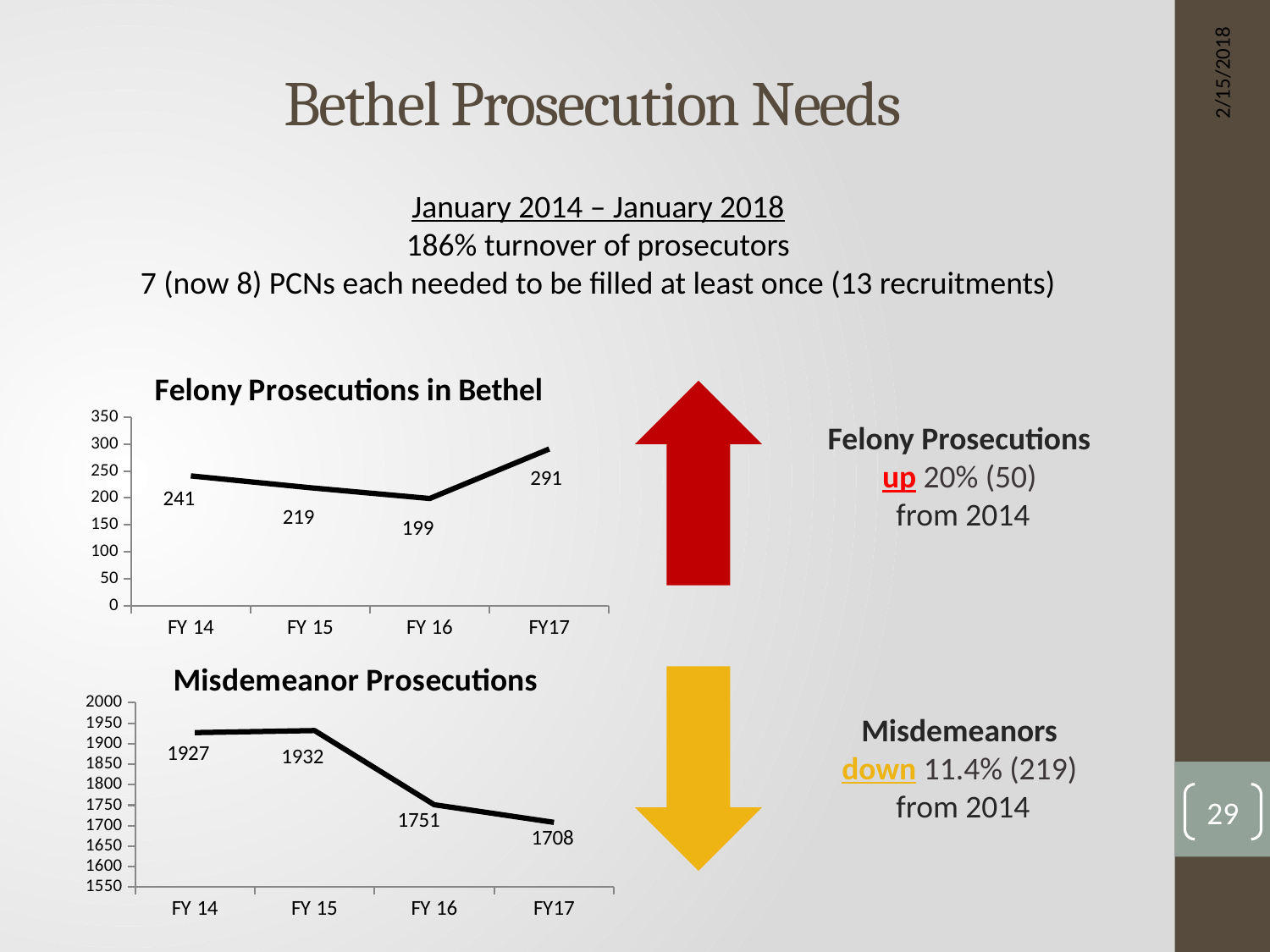
In the 'Misdemeanor Prosecutions' chart, what is the difference between the FY 14 value and the FY17 value? 219 In the 'Felony Prosecutions in Bethel' chart, how many data points are plotted? 4 In the 'Misdemeanor Prosecutions' chart, what is the value for FY17? 1708 In the 'Misdemeanor Prosecutions' chart, is the value for FY 16 larger or smaller than the value for FY 15? Smaller In the 'Felony Prosecutions in Bethel' chart, which fiscal year has the highest value? FY17 In the 'Felony Prosecutions in Bethel' chart, what is the value for FY 16? 199 In the 'Misdemeanor Prosecutions' chart, do the values generally rise or fall from FY 14 to FY17? Fall In the 'Felony Prosecutions in Bethel' chart, which fiscal year has the lowest value? FY 16 In the 'Felony Prosecutions in Bethel' chart, what is the difference between the FY17 value and the FY 14 value? 50 In the 'Misdemeanor Prosecutions' chart, what is the value for FY 15? 1932 In the 'Misdemeanor Prosecutions' chart, which fiscal year has the lowest value? FY17 What type of chart is 'Felony Prosecutions in Bethel'? Line chart